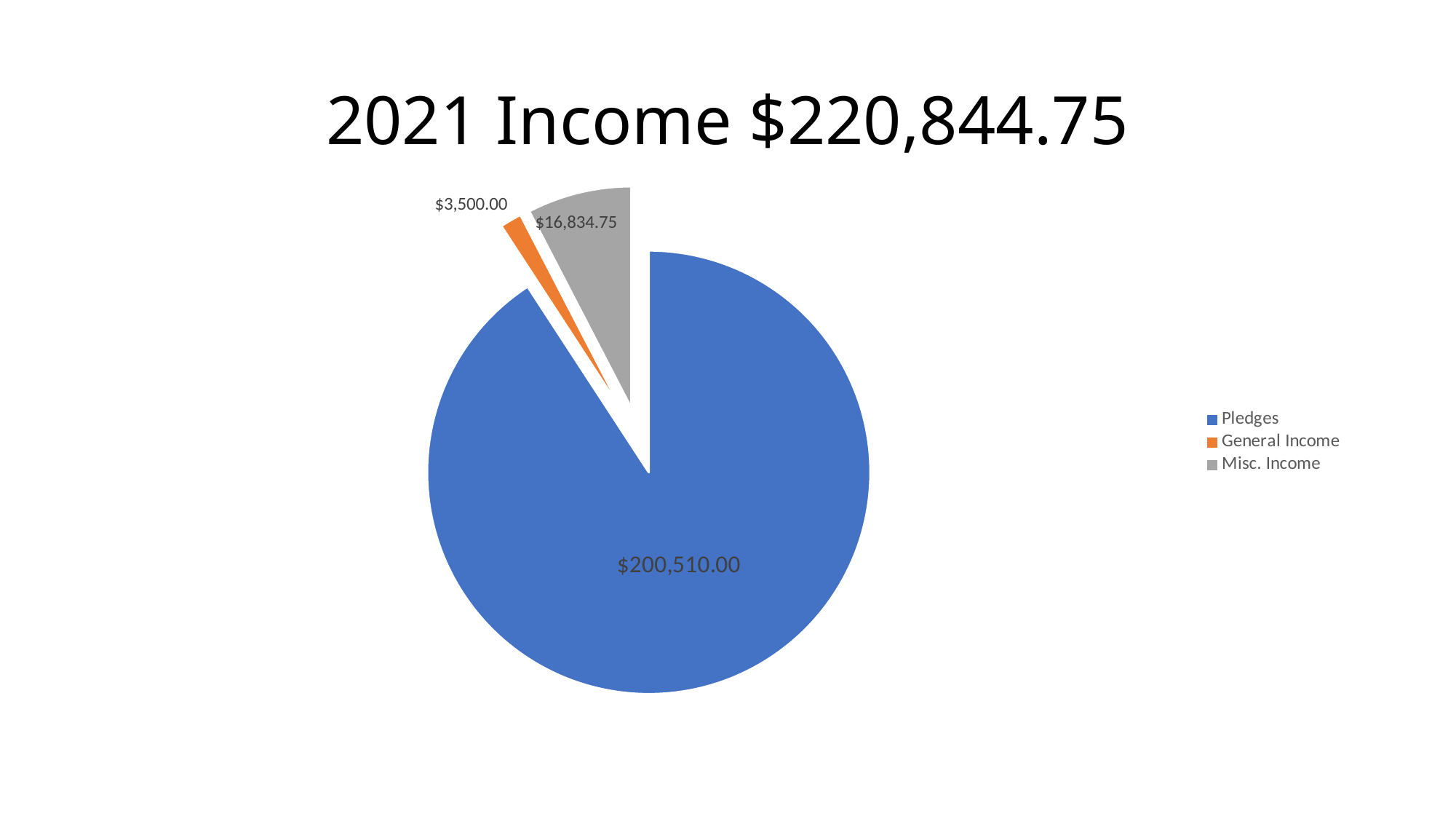
Which colour represents Misc. Income in the legend? Gray What type of chart is shown on the slide? Pie chart What is the difference between the Pledges value and the Misc. Income value? $183,675.25 What is the difference between the Misc. Income value and the General Income value? $13,334.75 What is the value of the General Income slice? $3,500.00 What is the title of the chart? 2021 Income $220,844.75 What is the value of the Pledges slice? $200,510.00 Which category has the largest slice of the pie? Pledges Which is larger, Misc. Income or General Income? Misc. Income What is the value of the Misc. Income slice? $16,834.75 Which category has the smallest slice of the pie? General Income How many categories does the pie chart show? 3